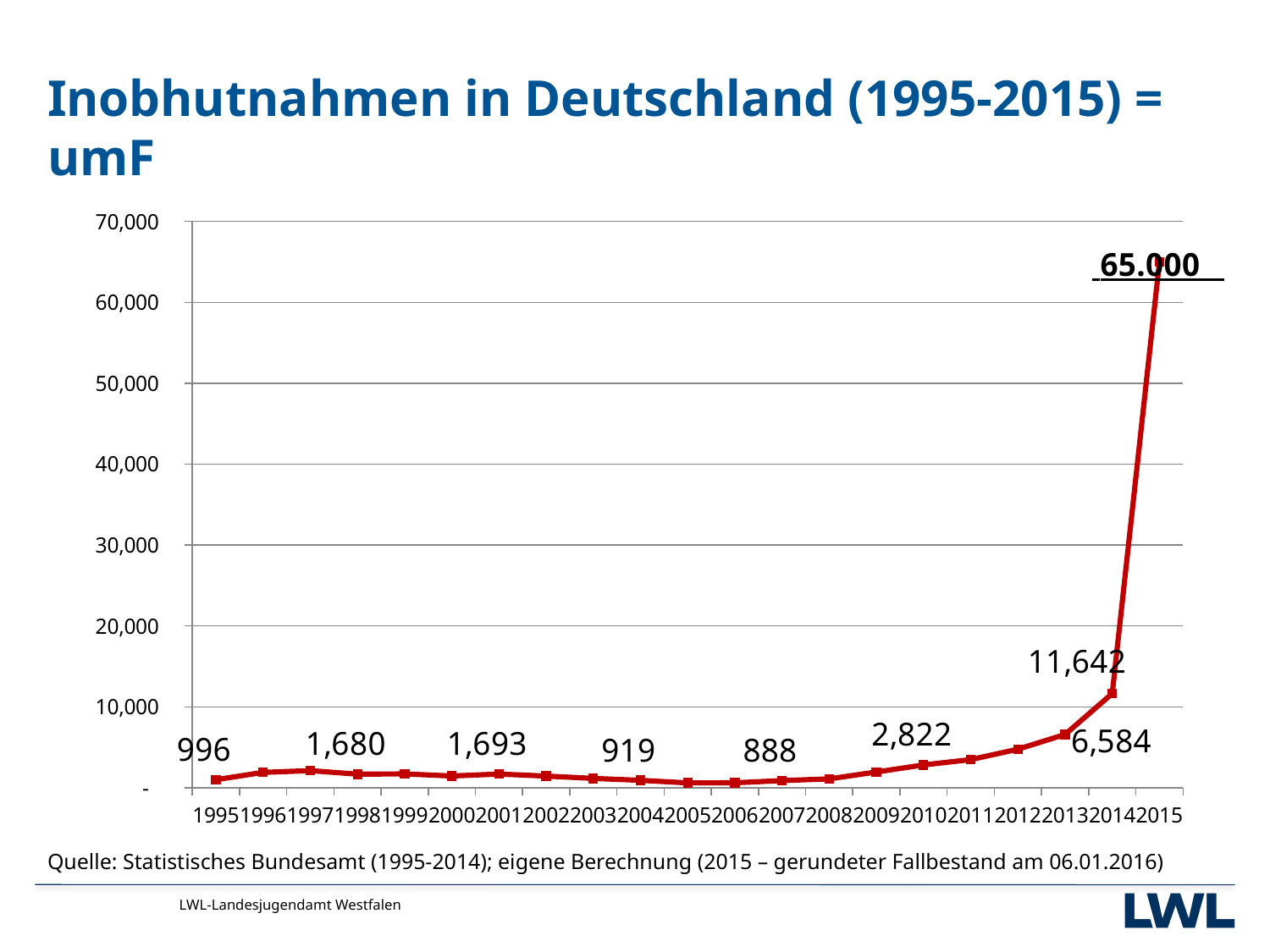
What is the value for 2014? 11,642 Do the values rise or fall between 2013 and 2015? rise What is the value for 2013? 6,584 What type of chart is shown on the slide? line chart Which is larger, the value for 2014 or the value for 2013? 2014 How many years are plotted on the x axis? 21 What is the difference between the values for 2014 and 2013? 5,058 Is the value for 2013 greater or less than 10,000? less Is the value for 2014 greater or less than 10,000? greater What is the value for 1995? 996 Which year has the highest value? 2015 What is the value for 2015? 65.000